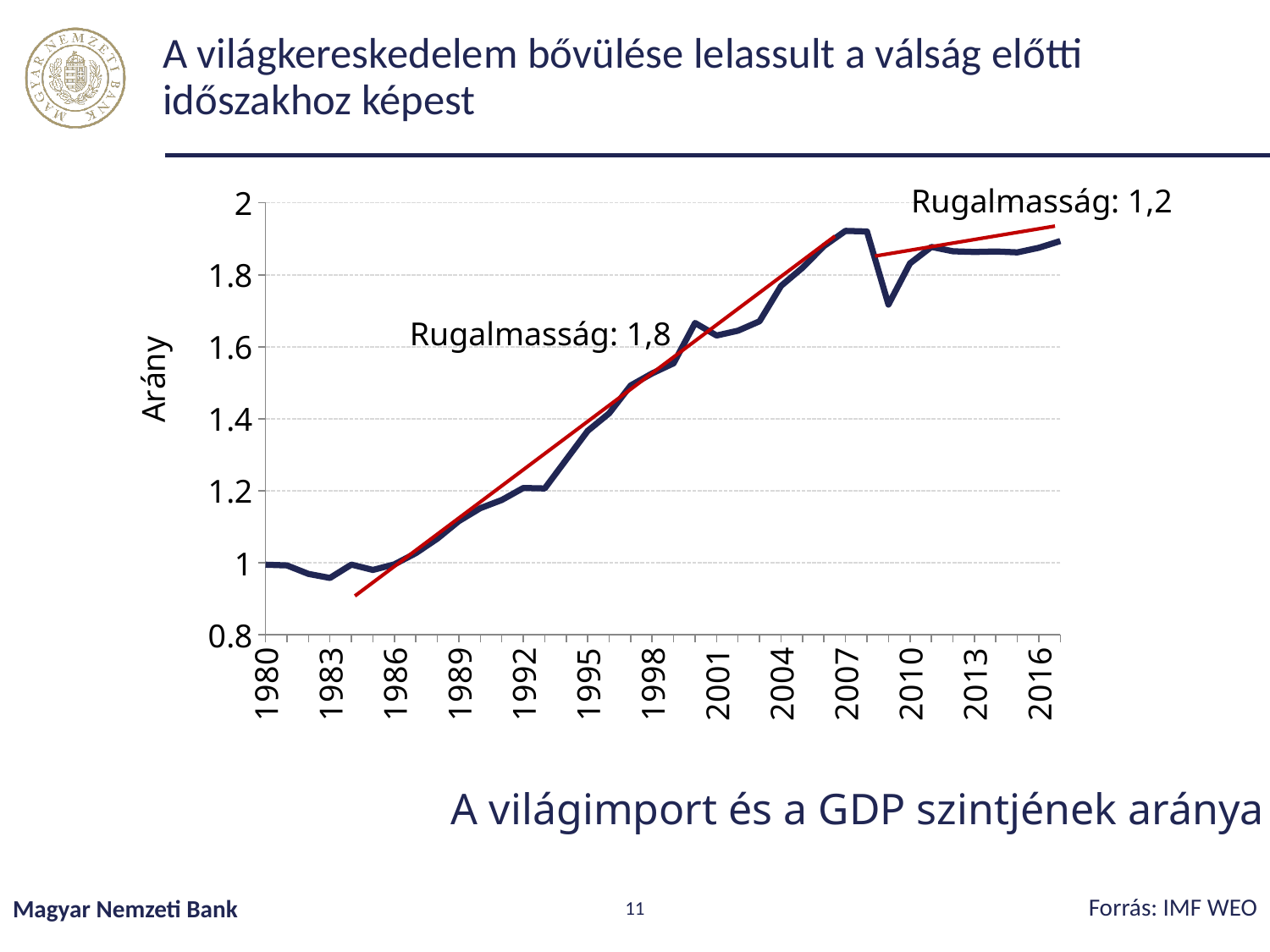
What is the title of the chart? A világimport és a GDP szintjének aránya What kind of chart is shown on the slide? line chart Is the value for 2001 greater or less than 1.4? greater Is the value for 2007 greater or less than 1.8? greater Is the value for 1980 greater or less than 1.2? less What is the label of the vertical axis? Arány Which year has the larger value, 2007 or 2009? 2007 What elasticity (Rugalmasság) value is printed for the earlier, pre-crisis trend line? 1,8 Does the ratio generally rise or fall between 1986 and 2007? rise What elasticity (Rugalmasság) value is printed for the later, post-crisis trend line? 1,2 How many year labels are shown on the horizontal axis? 13